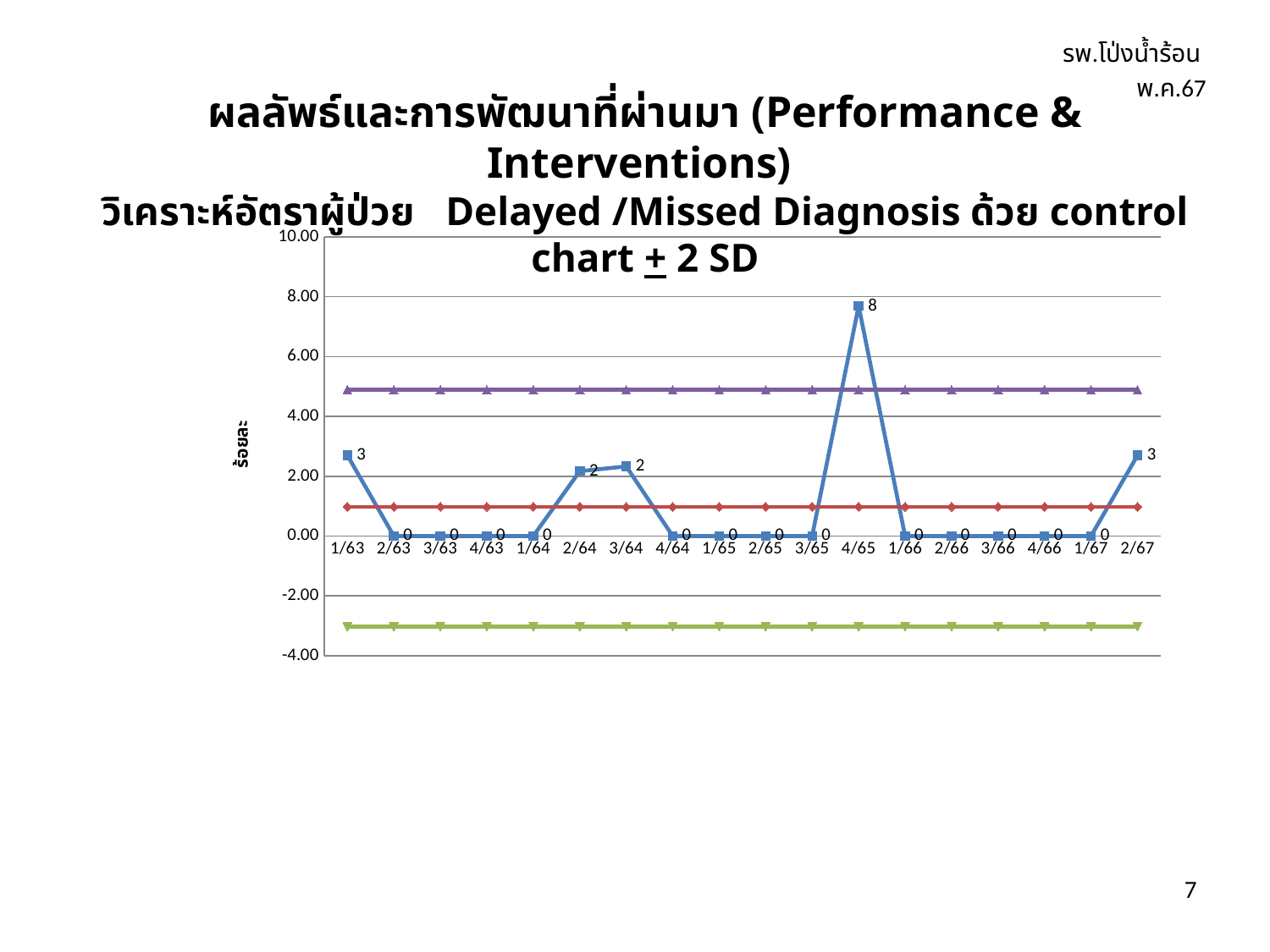
Does the plotted value rise or fall from 3/65 to 4/65? rise Is the upper control limit line (purple) greater or less than 6.00? less What is the value plotted for 1/63? 3 What is the label on the y axis? ร้อยละ How many periods are shown on the x axis? 18 What type of chart is shown on the slide? line chart What is the value plotted for 4/65? 8 What is the value plotted for 2/67? 3 What is the value plotted for 2/64? 2 Which is larger, the value for 3/64 or the value for 1/63? 1/63 What is the difference between the value for 4/65 and the value for 2/67? 5 Which period has the highest plotted value? 4/65